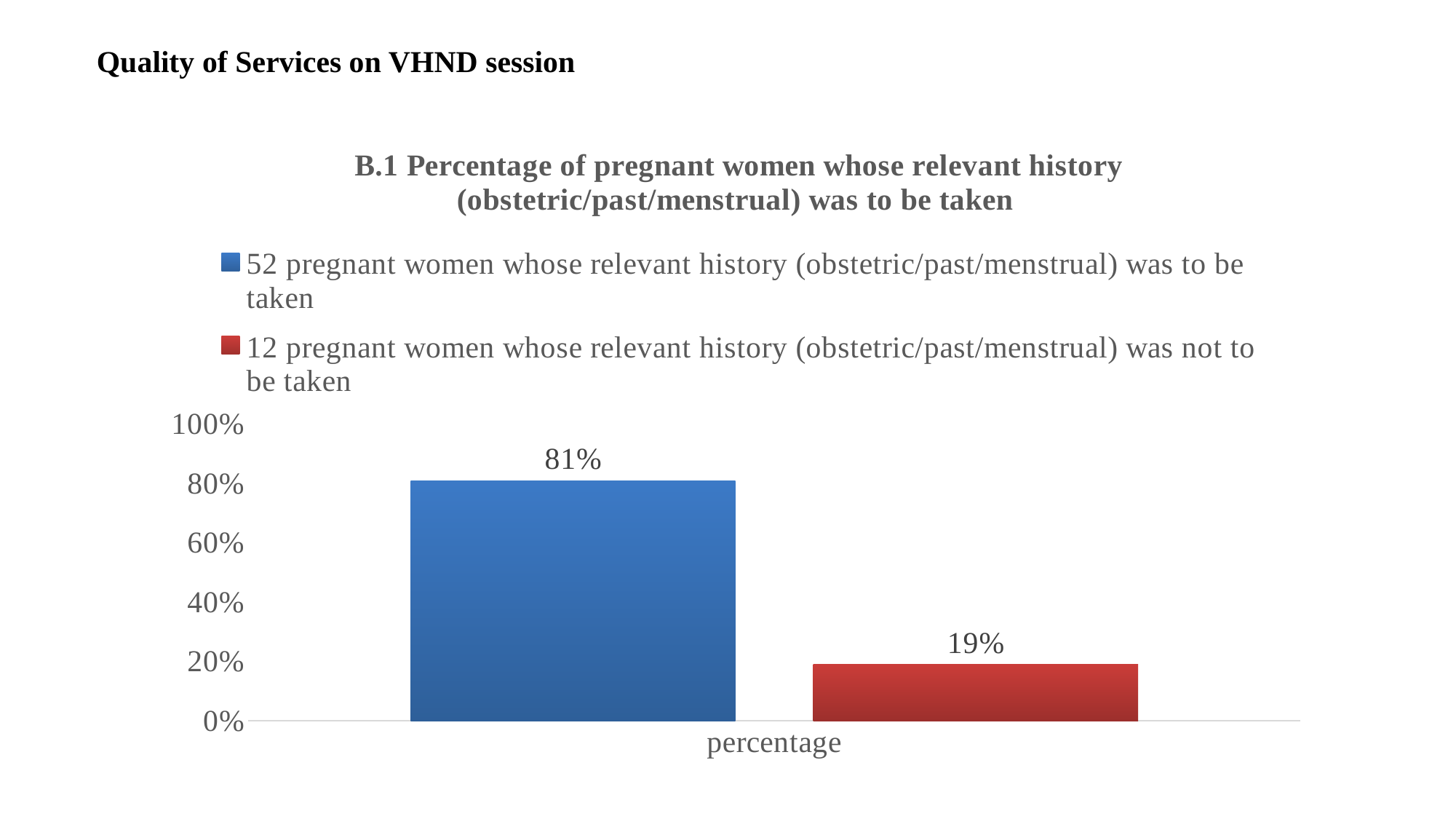
What is the value of the red bar for the series '12 pregnant women whose relevant history (obstetric/past/menstrual) was not to be taken'? 19% What is the difference between the value for women whose history was to be taken and the value for women whose history was not to be taken? 62% What is the title of the chart? B.1 Percentage of pregnant women whose relevant history (obstetric/past/menstrual) was to be taken What is the total of the two bar values shown in the chart? 100% Is the value for women whose history was not to be taken greater or less than 40%? less What is the label on the x axis of the chart? percentage What is the value of the blue bar for the series '52 pregnant women whose relevant history (obstetric/past/menstrual) was to be taken'? 81% Which series has the lower value in the chart? 12 pregnant women whose relevant history (obstetric/past/menstrual) was not to be taken Which series has the higher value in the chart? 52 pregnant women whose relevant history (obstetric/past/menstrual) was to be taken Is the value for women whose history was to be taken greater or less than 60%? greater How many series does the legend list? 2 What kind of chart is shown on the slide? Bar chart